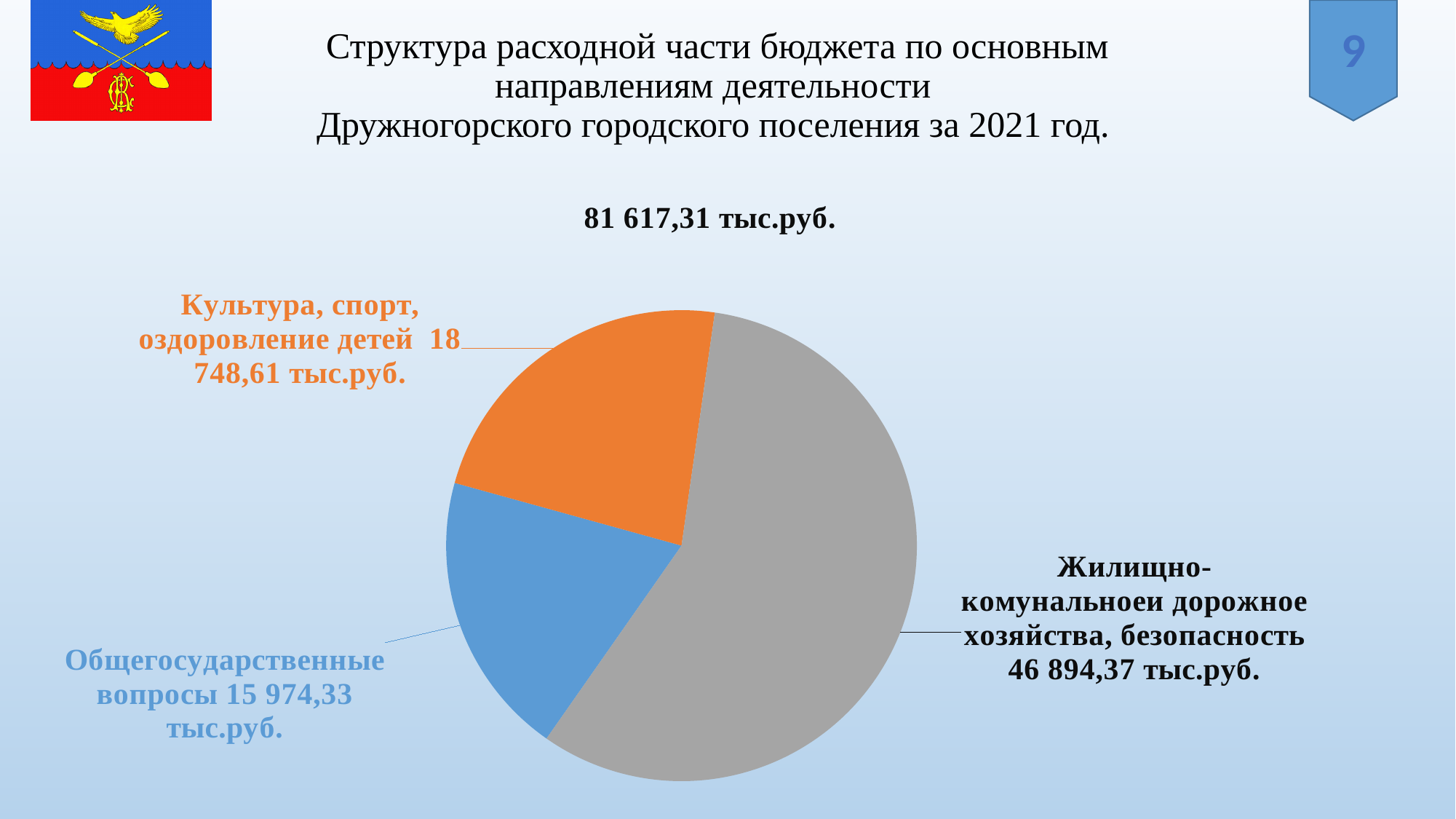
What is the value for Общегосударственные вопросы? 15 974,33 тыс.руб. What colour is the slice for Общегосударственные вопросы? Blue What is the difference between Жилищно-комунальноеи дорожное хозяйства, безопасность and Культура, спорт, оздоровление детей? 28 145,76 тыс.руб. How many slices does the pie chart have? 3 What total value is shown as the title above the pie chart? 81 617,31 тыс.руб. Which is larger: Культура, спорт, оздоровление детей or Общегосударственные вопросы? Культура, спорт, оздоровление детей Which category has the largest slice of the pie? Жилищно-комунальноеи дорожное хозяйства, безопасность What kind of chart is shown on the slide? Pie chart What is the value for Жилищно-комунальноеи дорожное хозяйства, безопасность? 46 894,37 тыс.руб. Which category has the smallest slice of the pie? Общегосударственные вопросы What is the value for Культура, спорт, оздоровление детей? 18 748,61 тыс.руб. What is the difference between Культура, спорт, оздоровление детей and Общегосударственные вопросы? 2 774,28 тыс.руб.